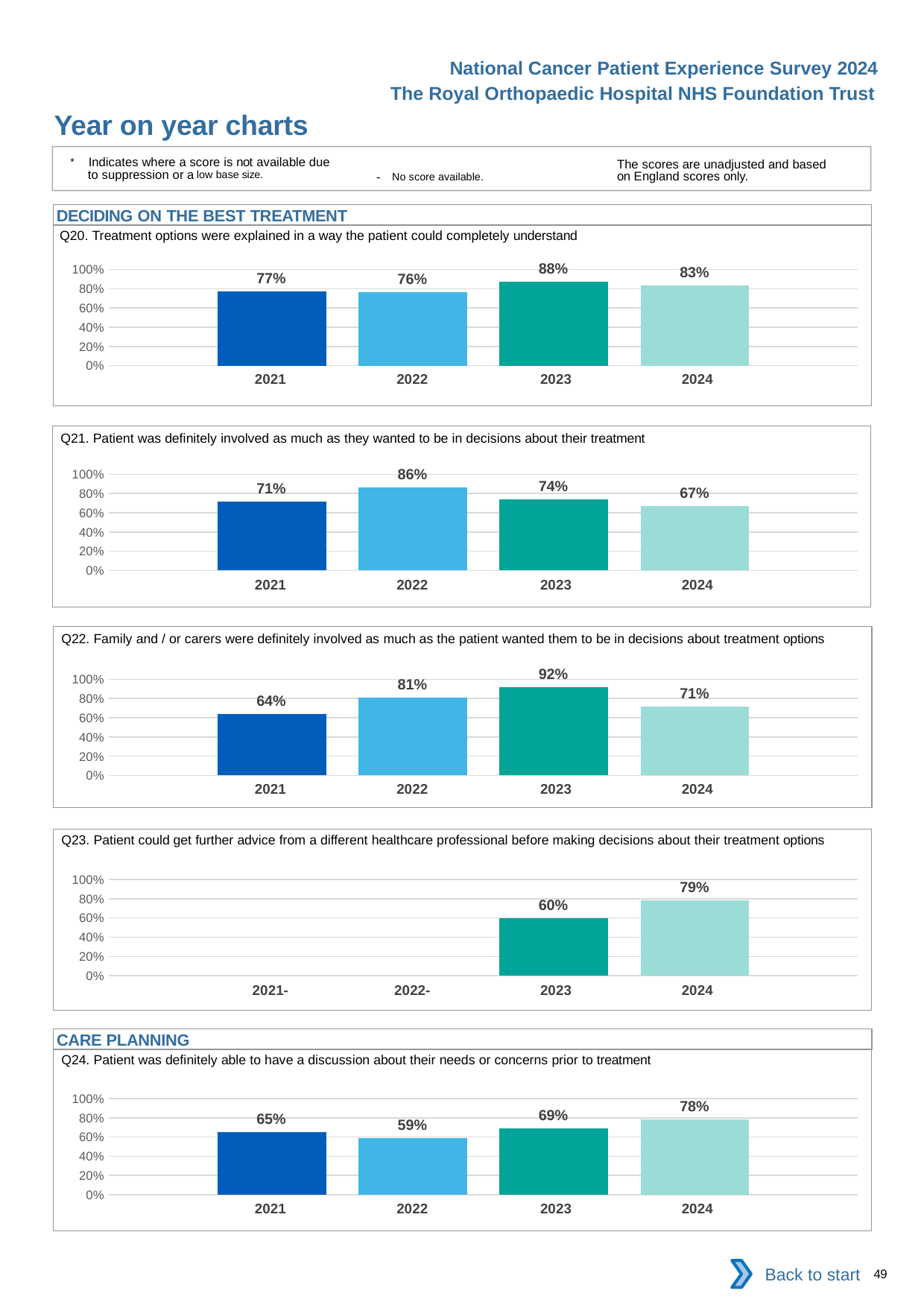
Which section heading appears above the Q24 chart? CARE PLANNING In the Q21 chart, which year has the highest value? 2022 In the Q23 chart, how many years have a bar plotted? 2 In the Q20 chart, what is the value for 2023? 88% In the Q24 chart, do the values rise or fall from 2022 to 2024? rise In the Q24 chart, what is the difference between the 2024 and 2022 values? 19 percentage points In the Q22 chart, which is larger, the value for 2022 or the value for 2024? 2022 In the Q22 chart, what is the value for 2021? 64% In the Q20 chart, which year has the lowest value? 2022 In the Q23 chart, what is the value for 2024? 79% What kind of chart is used for Q20? bar chart In the Q21 chart, what is the difference between the 2022 and 2024 values? 19 percentage points